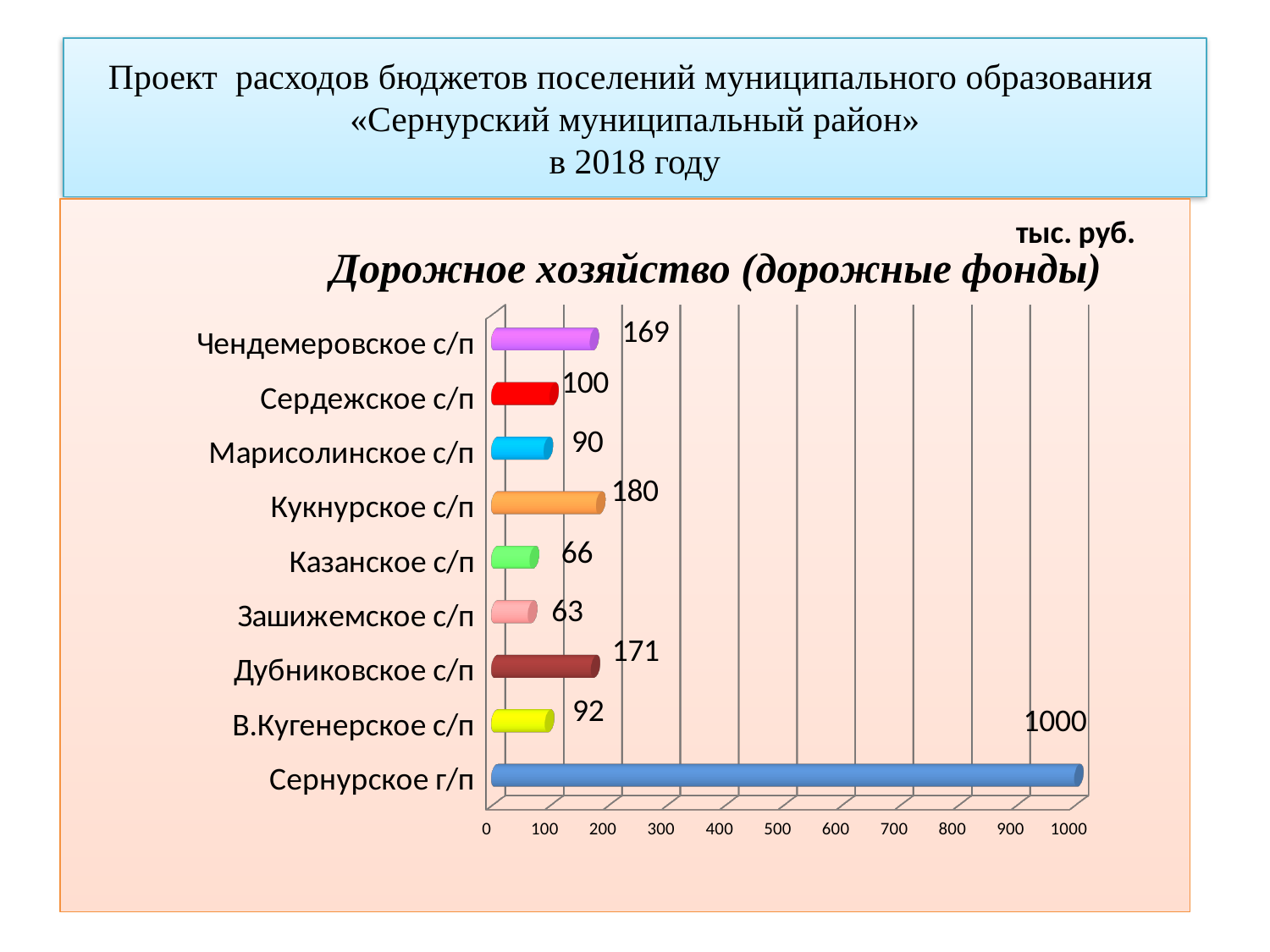
What is the value for Зашижемское с/п? 63 Which category has the lowest value? Зашижемское с/п What is the difference between the values for Дубниковское с/п and В.Кугенерское с/п? 79 What is the value for Сернурское г/п? 1000 How many categories are shown in the chart? 9 Which is larger, the value for Чендемеровское с/п or the value for Сердежское с/п? Чендемеровское с/п What unit is indicated above the chart? тыс. руб. What is the title of the chart? Дорожное хозяйство (дорожные фонды) Which category has the highest value? Сернурское г/п What is the value for Кукнурское с/п? 180 Is the value for Марисолинское с/п greater or less than 100? less What kind of chart is shown on the slide? bar chart